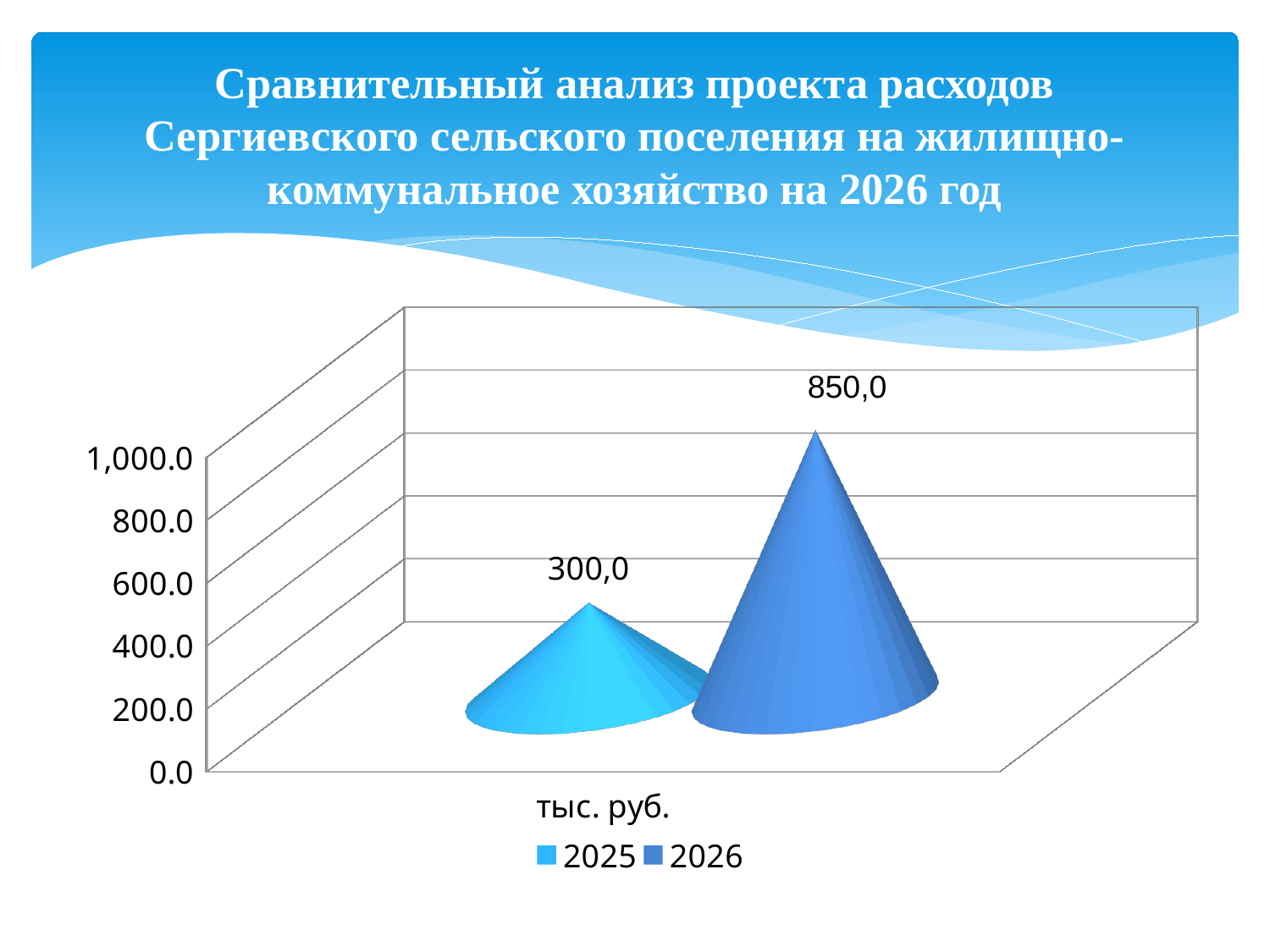
Is the value for 2026 greater or less than 600.0? greater Which series has the higher value, 2025 or 2026? 2026 What is the value for the 2026 series? 850,0 Is the value for 2025 greater or less than 400.0? less Is the value for 2025 larger or smaller than the value for 2026? smaller What is the value for the 2025 series? 300,0 What is the difference between the 2026 value and the 2025 value? 550,0 Which series has the lower value? 2025 What is the category label shown on the x axis? тыс. руб. How many series does the legend list? 2 What kind of chart is shown on the slide? bar chart What is the highest value shown on the vertical axis? 1,000.0